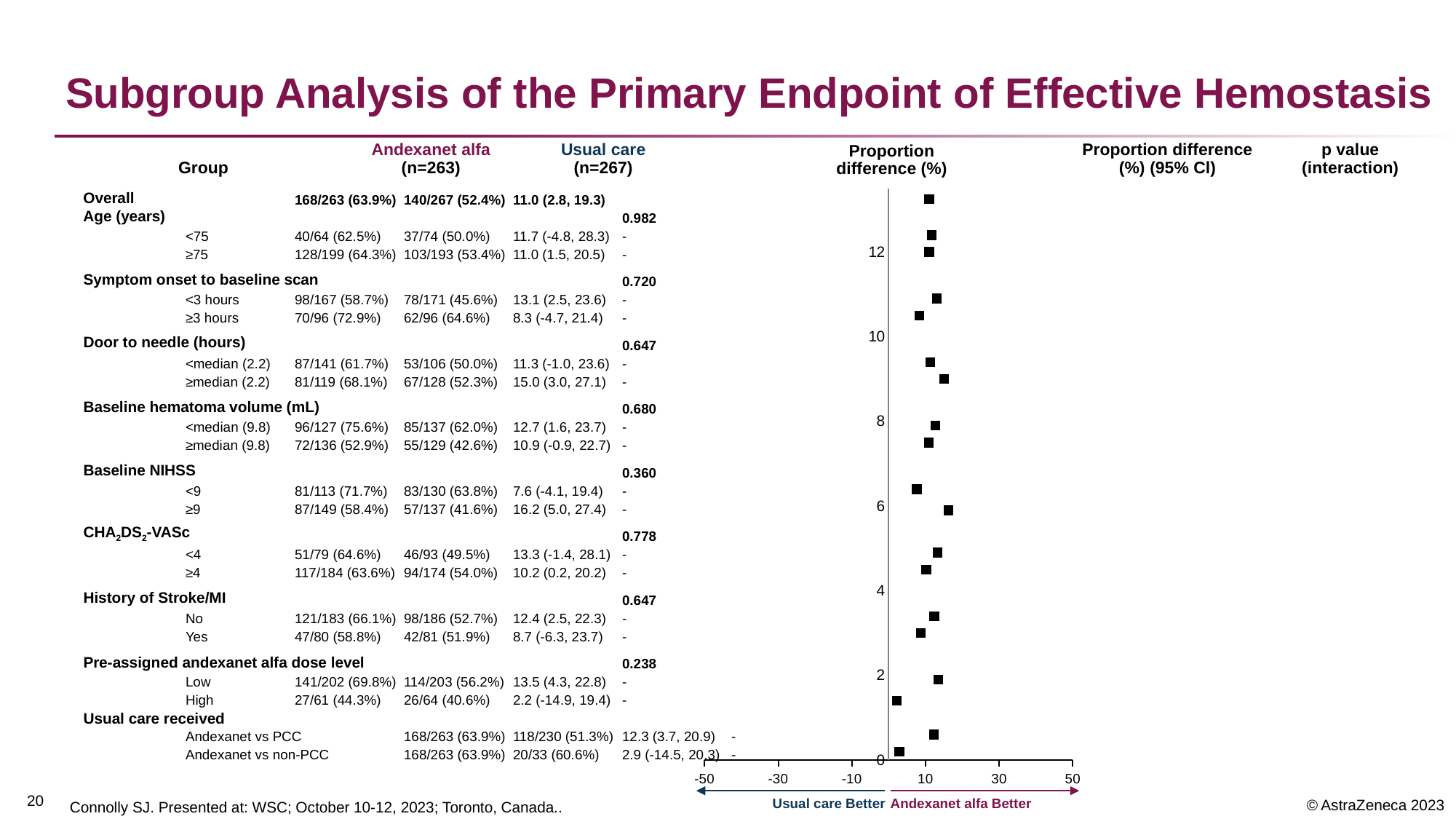
According to the x-axis label, which treatment is favoured by points to the right of the vertical line? Andexanet alfa Better Which has the larger proportion difference: symptom onset to baseline scan <3 hours or ≥3 hours? <3 hours What is the proportion difference (%) for the High pre-assigned andexanet alfa dose level subgroup? 2.2 What is the 95% CI for the overall proportion difference? (2.8, 19.3) What kind of chart is shown on the right side of the slide? forest plot (scatter of point estimates) What is the p value for interaction for Baseline NIHSS? 0.360 What is the overall proportion difference (%) between andexanet alfa and usual care? 11.0 Which subgroup has the lowest proportion difference? High dose level (2.2) Which subgroup has the highest proportion difference? Baseline NIHSS ≥9 (16.2) What is the proportion difference (%) for the Baseline NIHSS ≥9 subgroup? 16.2 What is the difference between the proportion difference for Age <75 (11.7) and Age ≥75 (11.0)? 0.7 Is the overall proportion difference greater or less than 30? less